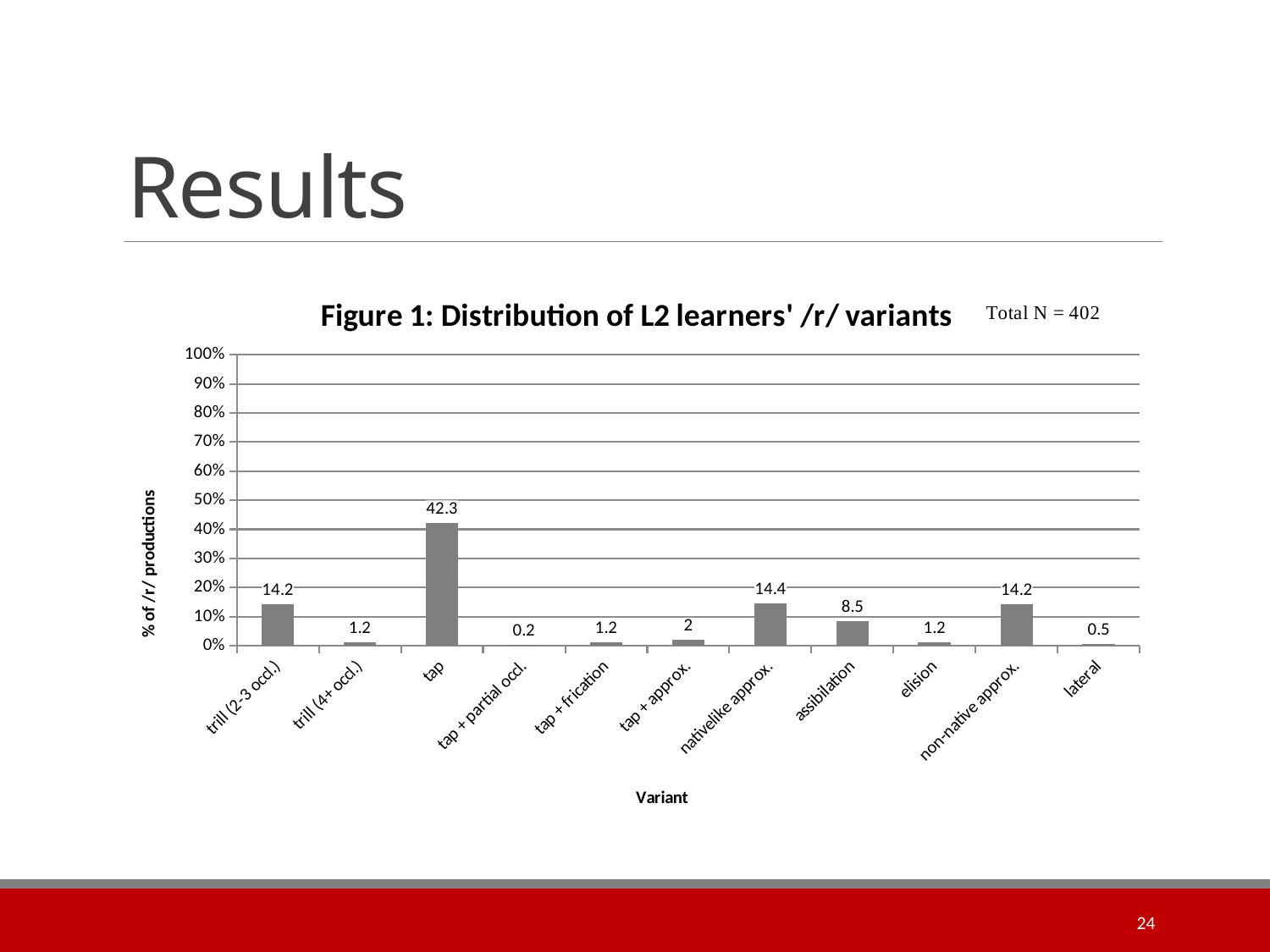
What is the value shown for tap? 42.3 What is the value shown for nativelike approx.? 14.4 What is the total N stated next to the chart title? 402 Which is larger, the value for assibilation or the value for tap + approx.? assibilation Which variant has the lowest percentage of /r/ productions? tap + partial occl. How many variant categories are shown on the x axis? 11 What is the value shown for assibilation? 8.5 What is the value shown for lateral? 0.5 Is the value for tap greater or less than 40%? greater What kind of chart is shown on the slide? bar chart What is the difference between the values for tap and nativelike approx.? 27.9 Which variant has the highest percentage of /r/ productions? tap